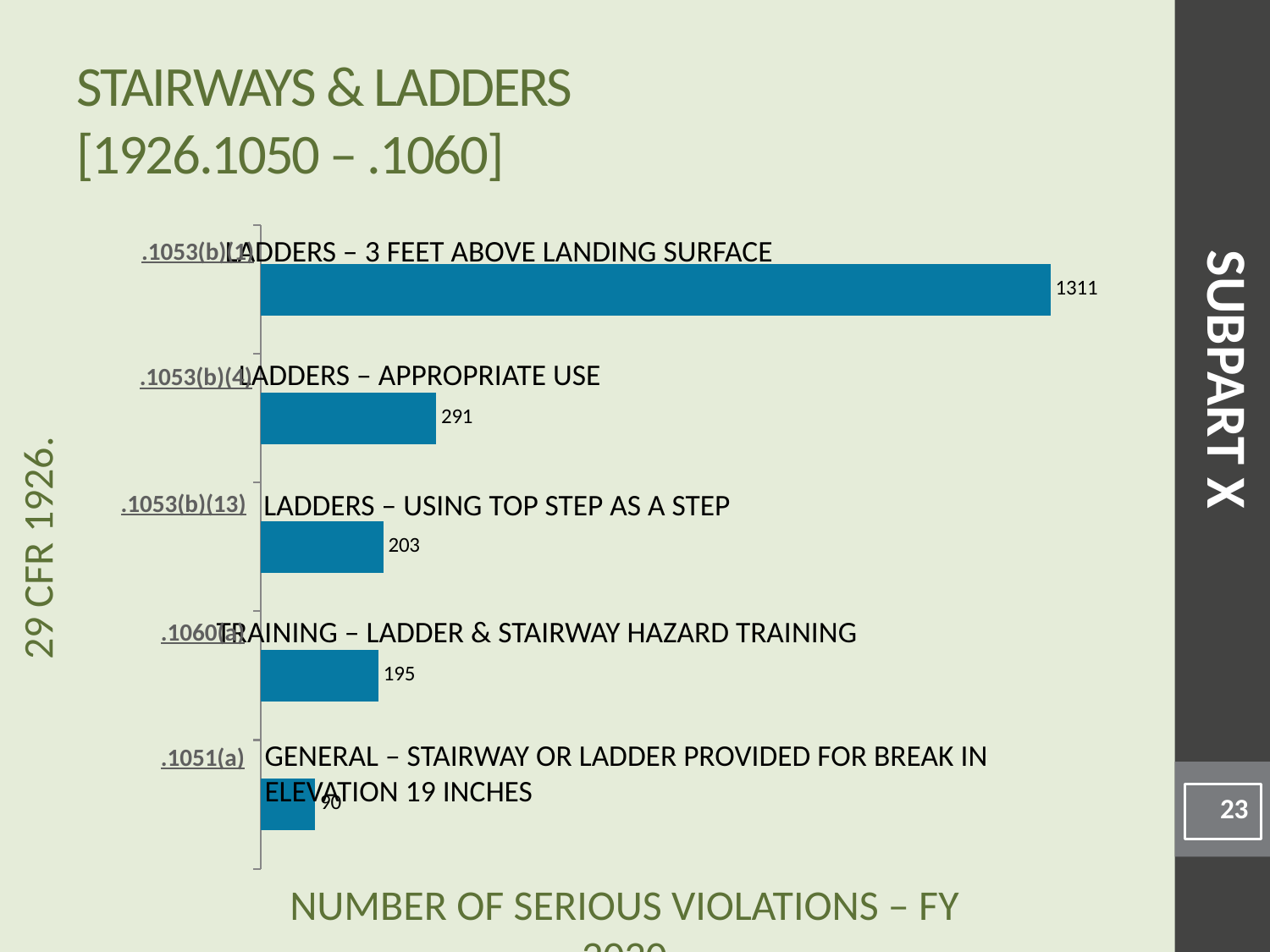
What is the number of serious violations for .1060(a) Training – ladder & stairway hazard training? 195 What is the number of serious violations for .1053(b)(4) Ladders – appropriate use? 291 What kind of chart is shown on the slide? bar chart Which standard has the highest number of serious violations? .1053(b)(1) Ladders – 3 feet above landing surface Which has more serious violations, .1053(b)(4) Ladders – appropriate use or .1053(b)(13) Ladders – using top step as a step? .1053(b)(4) Ladders – appropriate use What is the difference in serious violations between .1053(b)(1) and .1053(b)(4)? 1020 What is the number of serious violations for .1053(b)(1) Ladders – 3 feet above landing surface? 1311 How many categories (standards) are plotted in the chart? 5 What is the number of serious violations for .1053(b)(13) Ladders – using top step as a step? 203 Which standard has the lowest number of serious violations? .1051(a) General – stairway or ladder provided for break in elevation 19 inches What is the difference in serious violations between .1053(b)(13) and .1060(a)? 8